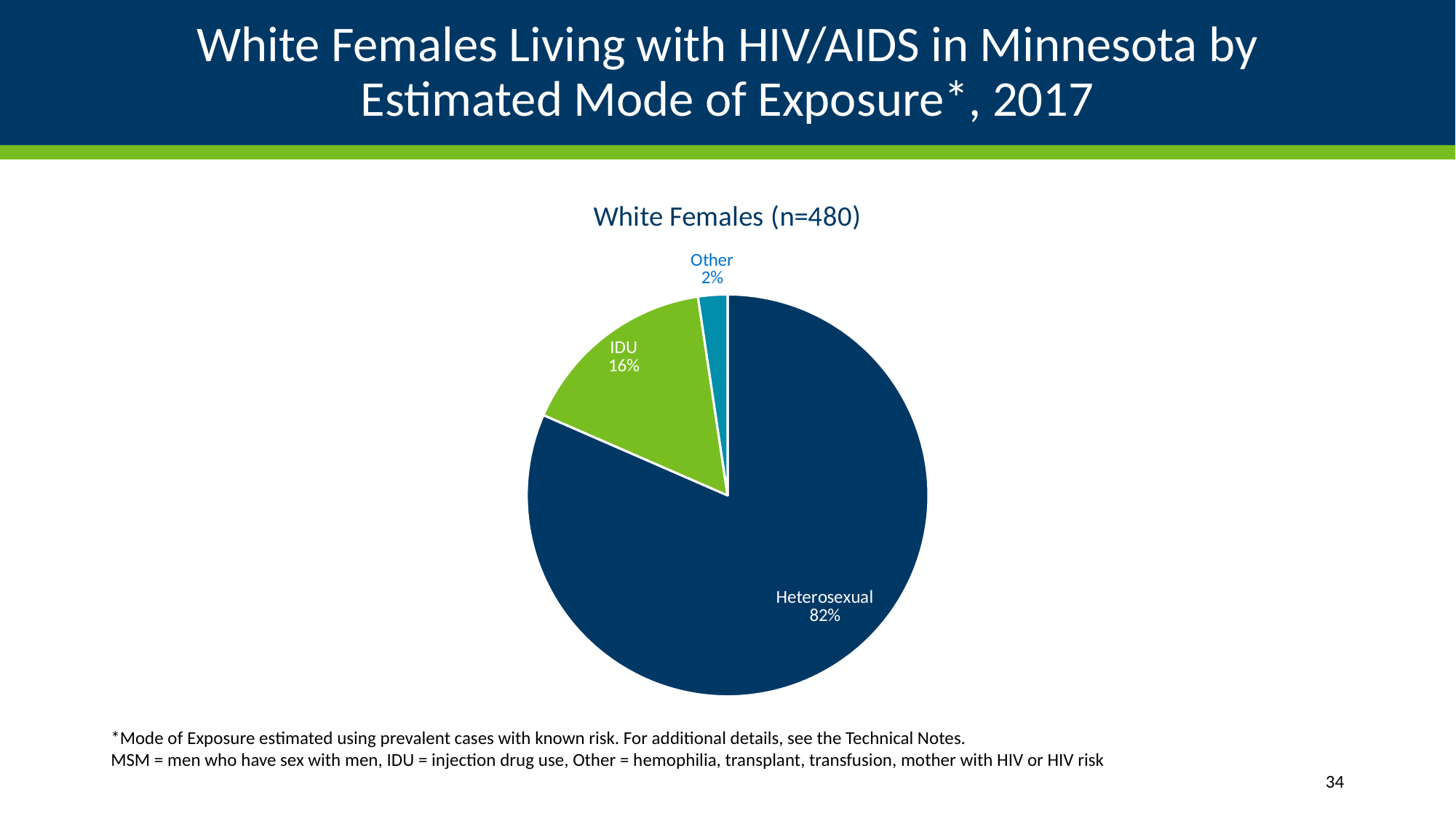
Which mode of exposure has the smallest share of the pie? Other Which mode of exposure has the largest share of the pie? Heterosexual What is the difference in percentage points between the IDU and Other shares? 14 What share of the pie is IDU? 16% What is the difference in percentage points between the Heterosexual and IDU shares? 66 What share of the pie is Heterosexual? 82% What colour is the IDU slice? Green How many slices does the pie chart have? 3 Which is larger, the IDU share or the Other share? IDU What share of the pie is Other? 2% What kind of chart is shown on the slide? Pie chart What is the title of the chart? White Females (n=480)